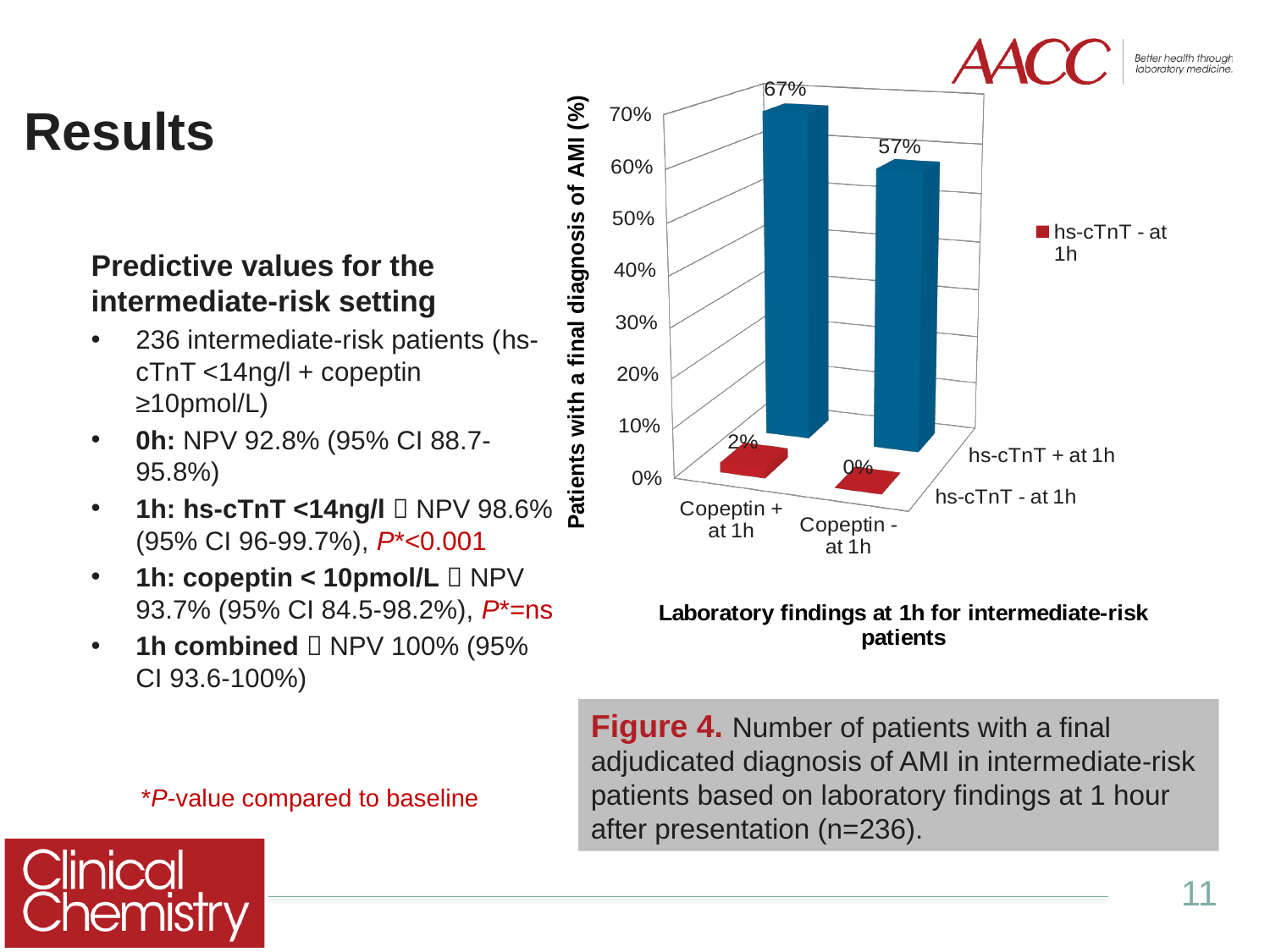
What is the value for Copeptin - at 1h in the hs-cTnT + at 1h series? 57% Which bar has the highest value in the chart? Copeptin + at 1h, hs-cTnT + at 1h What is the value for Copeptin + at 1h in the hs-cTnT - at 1h series? 2% Which bar has the lowest value in the chart? Copeptin - at 1h, hs-cTnT - at 1h What is the difference between the Copeptin + at 1h and Copeptin - at 1h values in the hs-cTnT + at 1h series? 10% Is the value for Copeptin - at 1h in the hs-cTnT + at 1h series greater or less than 50%? greater What kind of chart is shown on the slide? Bar chart What is the value for Copeptin - at 1h in the hs-cTnT - at 1h series? 0% What is the title of the chart? Laboratory findings at 1h for intermediate-risk patients How many categories are shown on the x axis of the chart? 2 In the hs-cTnT + at 1h series, which is larger: Copeptin + at 1h or Copeptin - at 1h? Copeptin + at 1h What is the value for Copeptin + at 1h in the hs-cTnT + at 1h series? 67%